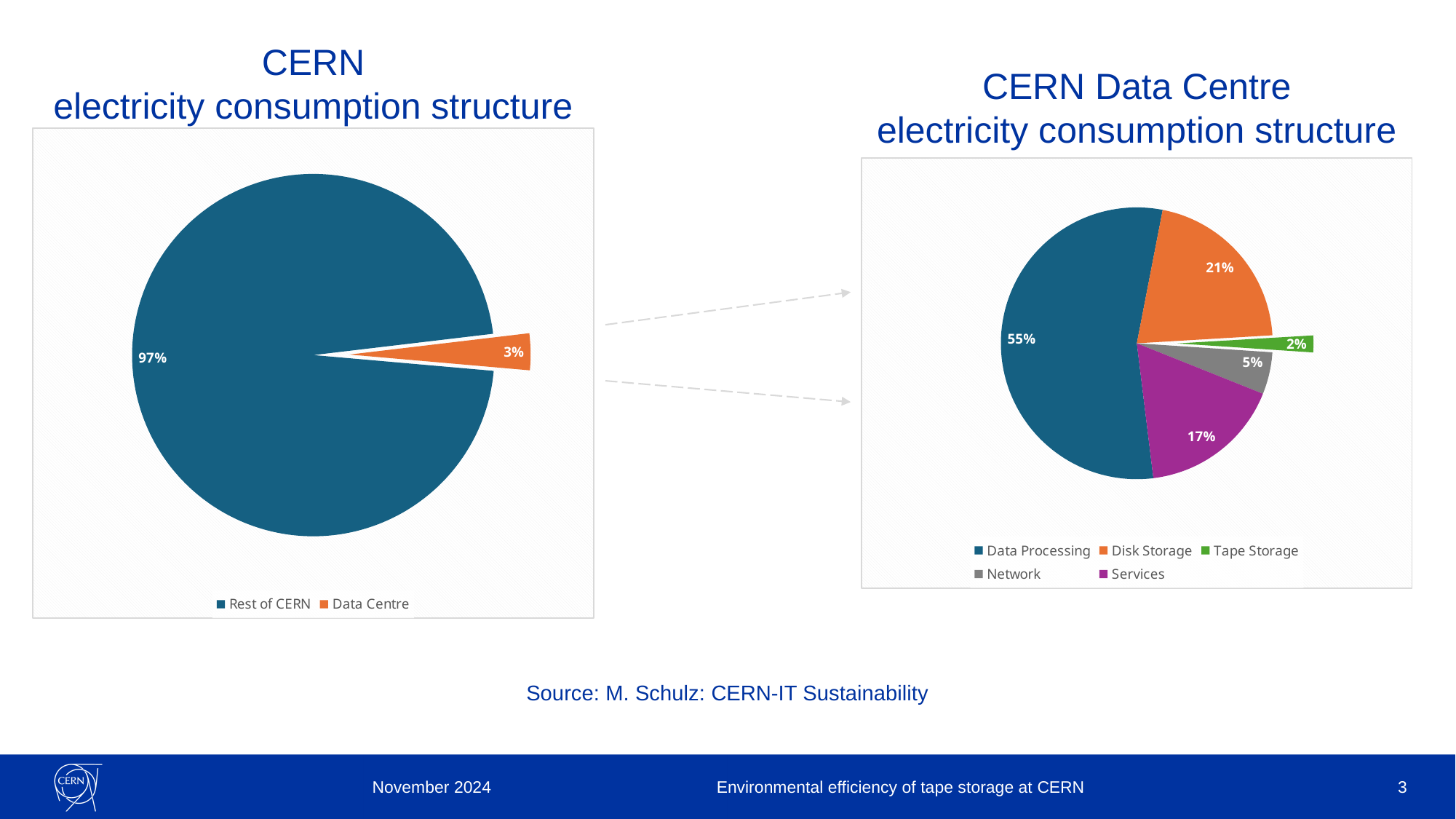
In the 'CERN electricity consumption structure' chart, what share of electricity consumption is attributed to the Data Centre? 3% In the 'CERN Data Centre electricity consumption structure' chart, what share is attributed to Data Processing? 55% What type of chart is the 'CERN electricity consumption structure' chart? Pie chart In the 'CERN Data Centre electricity consumption structure' chart, what share is attributed to Disk Storage? 21% How many categories does the legend of the 'CERN Data Centre electricity consumption structure' chart list? 5 How many categories does the 'CERN electricity consumption structure' chart show? 2 In the 'CERN Data Centre electricity consumption structure' chart, which is larger: Network or Services? Services In the 'CERN Data Centre electricity consumption structure' chart, which category has the largest share? Data Processing In the 'CERN Data Centre electricity consumption structure' chart, what share is attributed to Tape Storage? 2% In the 'CERN Data Centre electricity consumption structure' chart, which category has the smallest share? Tape Storage In the 'CERN electricity consumption structure' chart, what share is attributed to Rest of CERN? 97% In the 'CERN Data Centre electricity consumption structure' chart, what is the difference between the Disk Storage share and the Services share? 4%